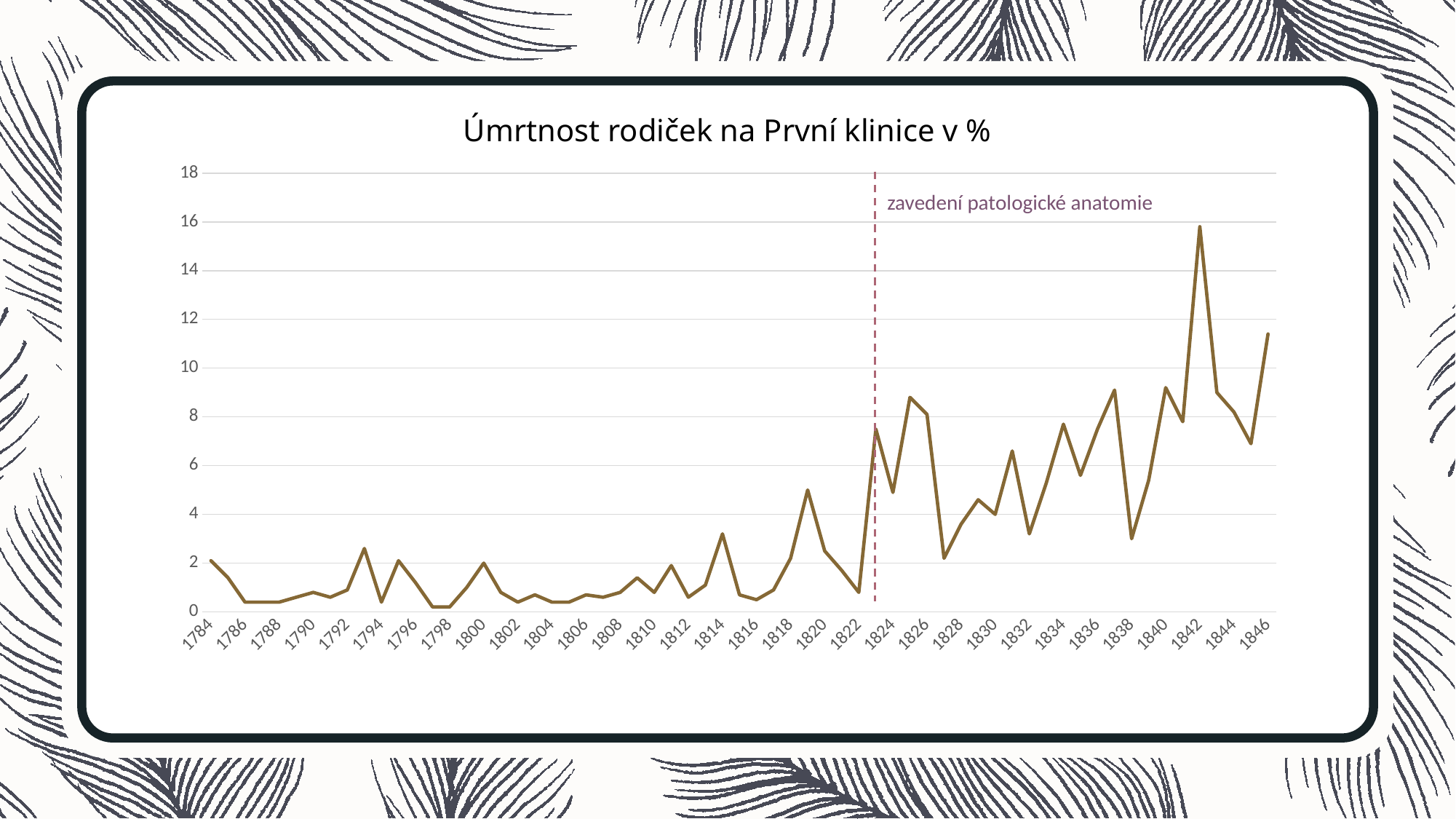
What kind of chart is shown on the slide? line chart Is the value for 1840 greater or less than 8? greater In which year does the line reach its highest value? 1842 What text labels the dashed vertical line in the chart? zavedení patologické anatomie Which year has the larger value, 1842 or 1846? 1842 Is the value for 1784 greater or less than 4? less What is the title of the chart? Úmrtnost rodiček na První klinice v % Is the value for 1846 greater or less than 10? greater Overall, do the values rise or fall from 1784 to 1846? rise